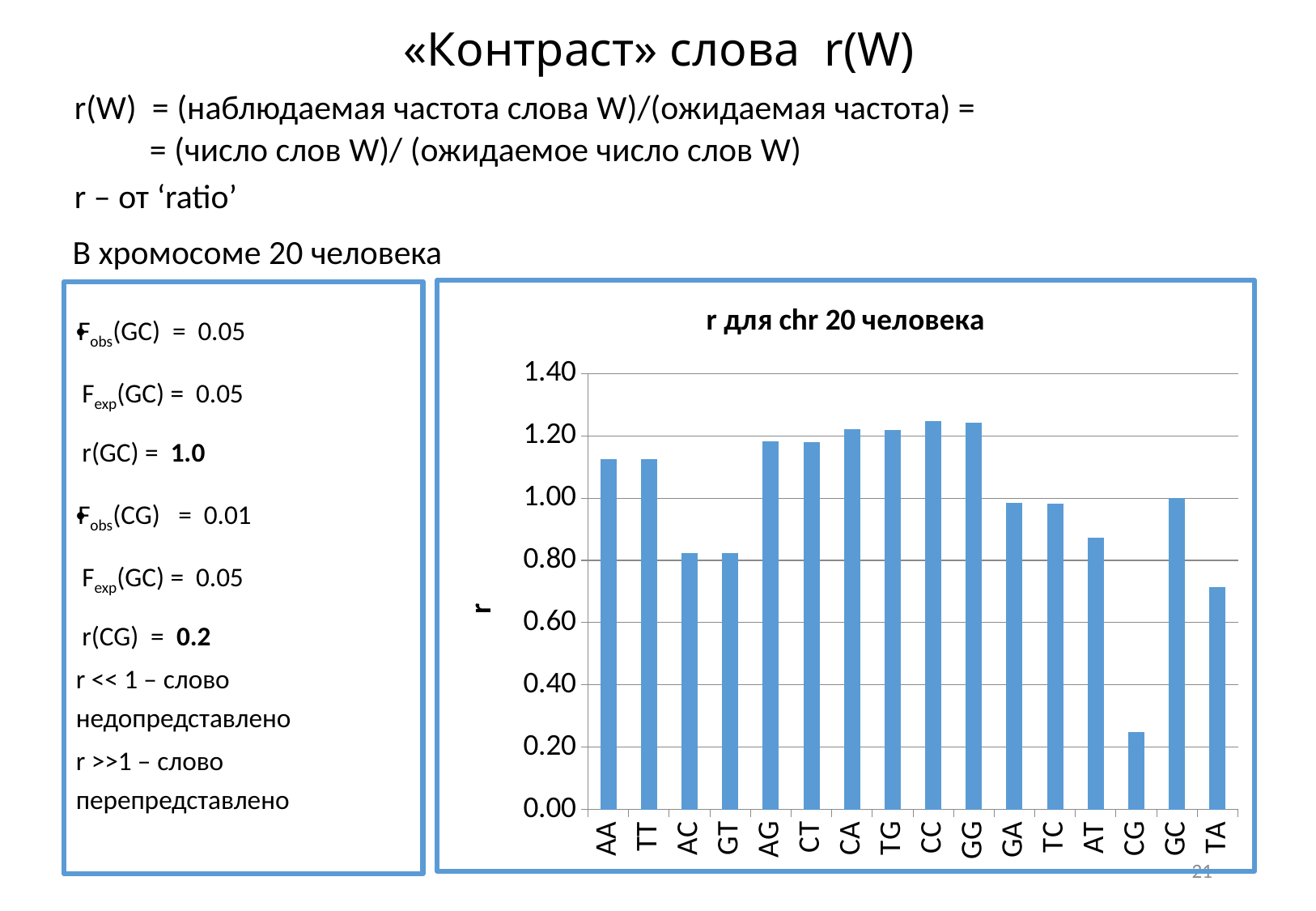
Is the value for CC greater or less than 1.20? greater Is the value for AA greater or less than 1.00? greater How many categories (words) are plotted on the x axis of the chart? 16 What is the label on the vertical axis of the chart? r What is the title of the chart? r для chr 20 человека Which has the larger value of r, CG or TA? TA What kind of chart is shown on the slide? bar chart Is the value for TA greater or less than 0.80? less Which has the larger value of r, AA or AC? AA Which category has the lowest value of r in the chart? CG